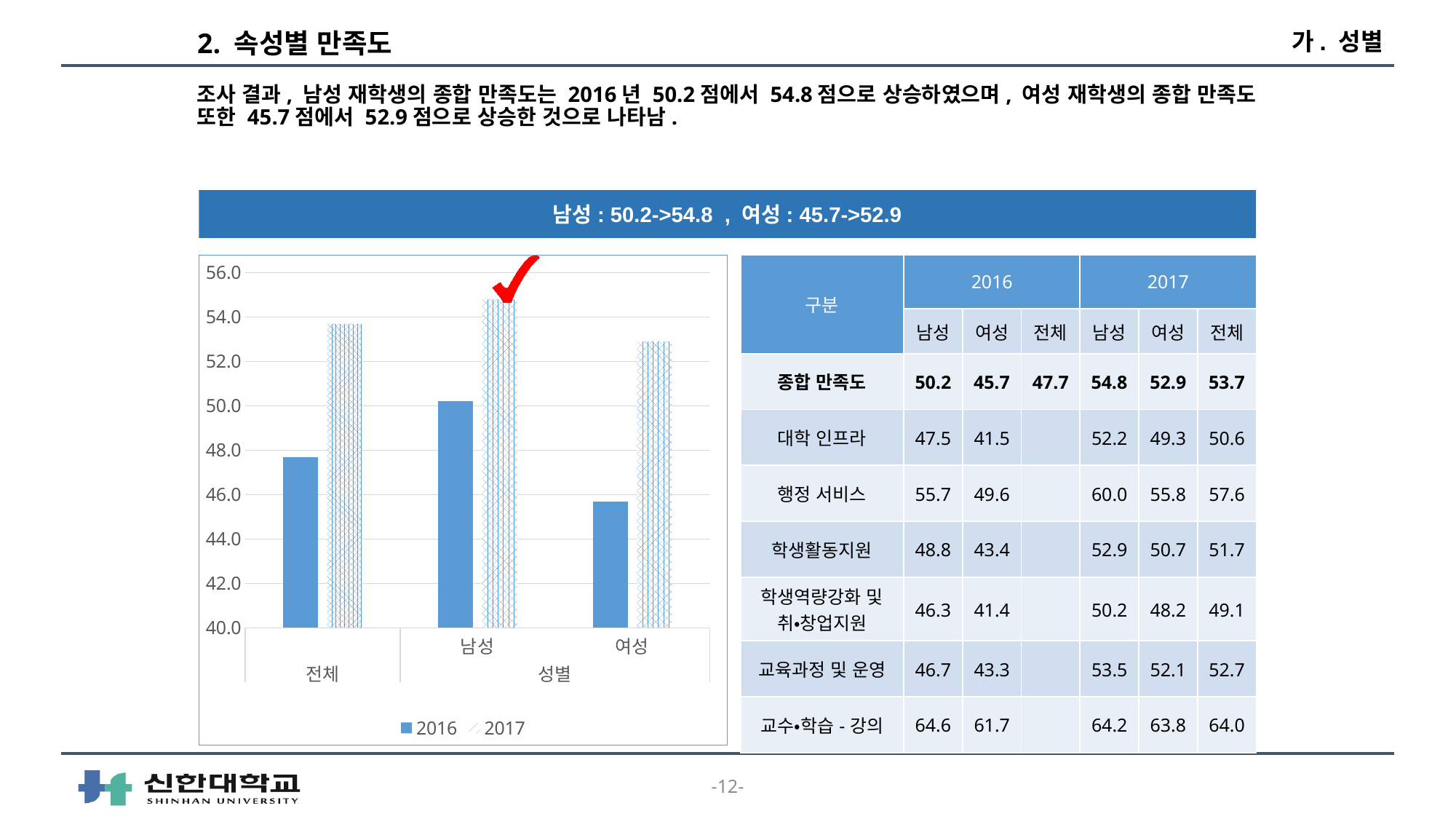
How many categories are shown on the x axis of the chart? 3 For 남성, is the 2017 bar higher or lower than the 2016 bar? higher Which category has the highest 2017 value in the chart? 남성 Which category has the lowest 2016 value in the chart? 여성 What kind of chart is shown on the slide? bar chart Is the 2016 value for 전체 greater or less than 48.0? less How many series does the chart legend list? 2 Which series are listed in the chart legend? 2016, 2017 Which is larger in the chart: the 2017 value for 전체 or the 2017 value for 여성? 2017 value for 전체 Is the 2016 value for 여성 greater or less than 46.0? less According to the slide, what is the 2017 종합 만족도 value for 여성? 52.9 Is the 2017 value for 남성 greater or less than 54.0? greater